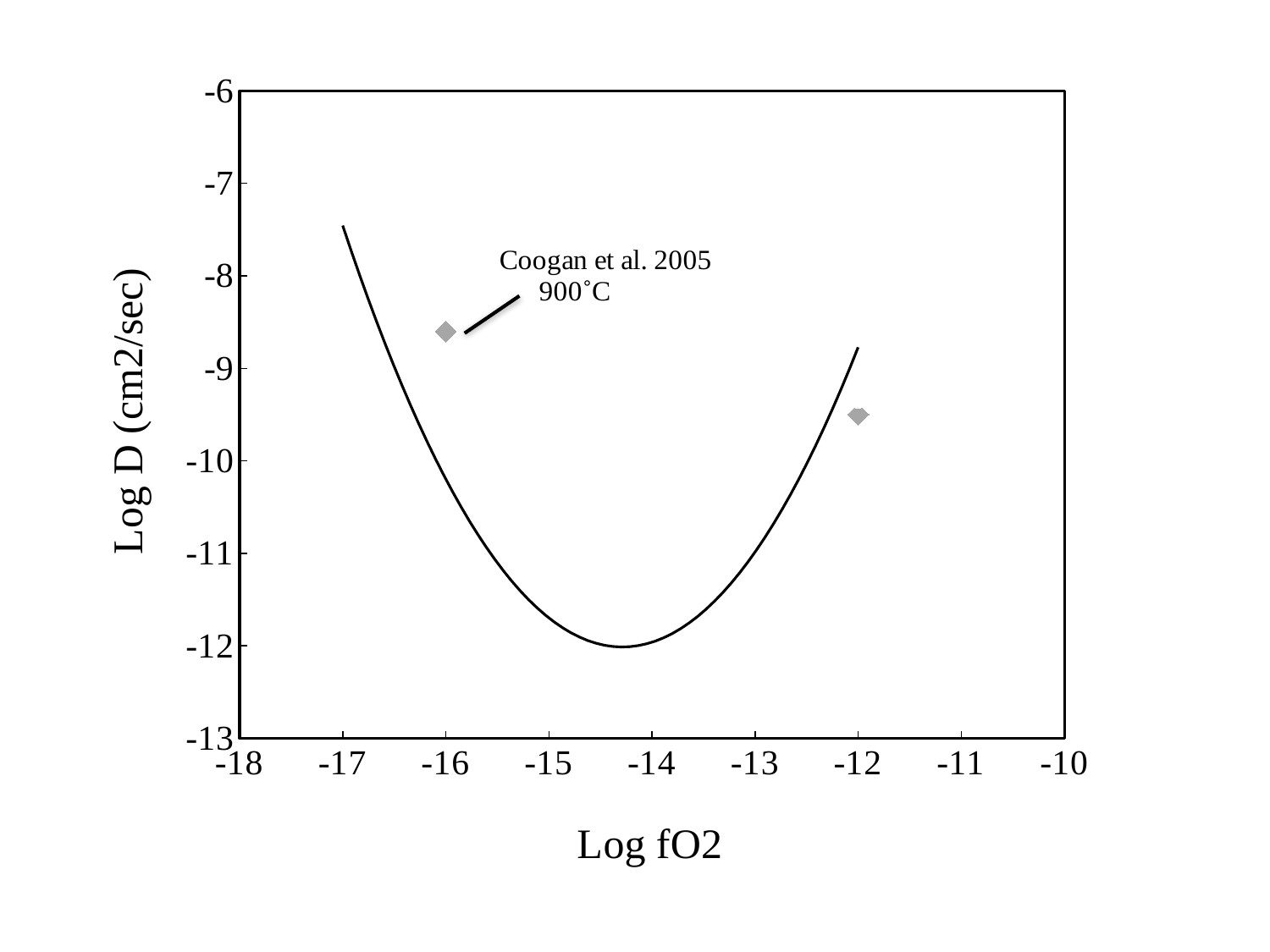
At what Log fO2 value is the left grey diamond point plotted? -16 How does the curve behave as Log fO2 increases from -17 to -12? It falls to a minimum near -14 and then rises How many grey diamond data points are plotted on the chart? 2 Is the lowest Log D value reached by the curve greater or less than -11? less What is the title of the y axis? Log D (cm2/sec) What kind of chart is shown on the slide? line chart At what Log fO2 value is the right grey diamond point plotted? -12 Is the Log D value of the grey diamond at Log fO2 = -12 greater or less than -9? less Which grey diamond point has the higher Log D value, the one at Log fO2 = -16 or the one at Log fO2 = -12? the one at Log fO2 = -16 What is the title of the x axis? Log fO2 Is the Log D value of the grey diamond at Log fO2 = -16 greater or less than -9? greater